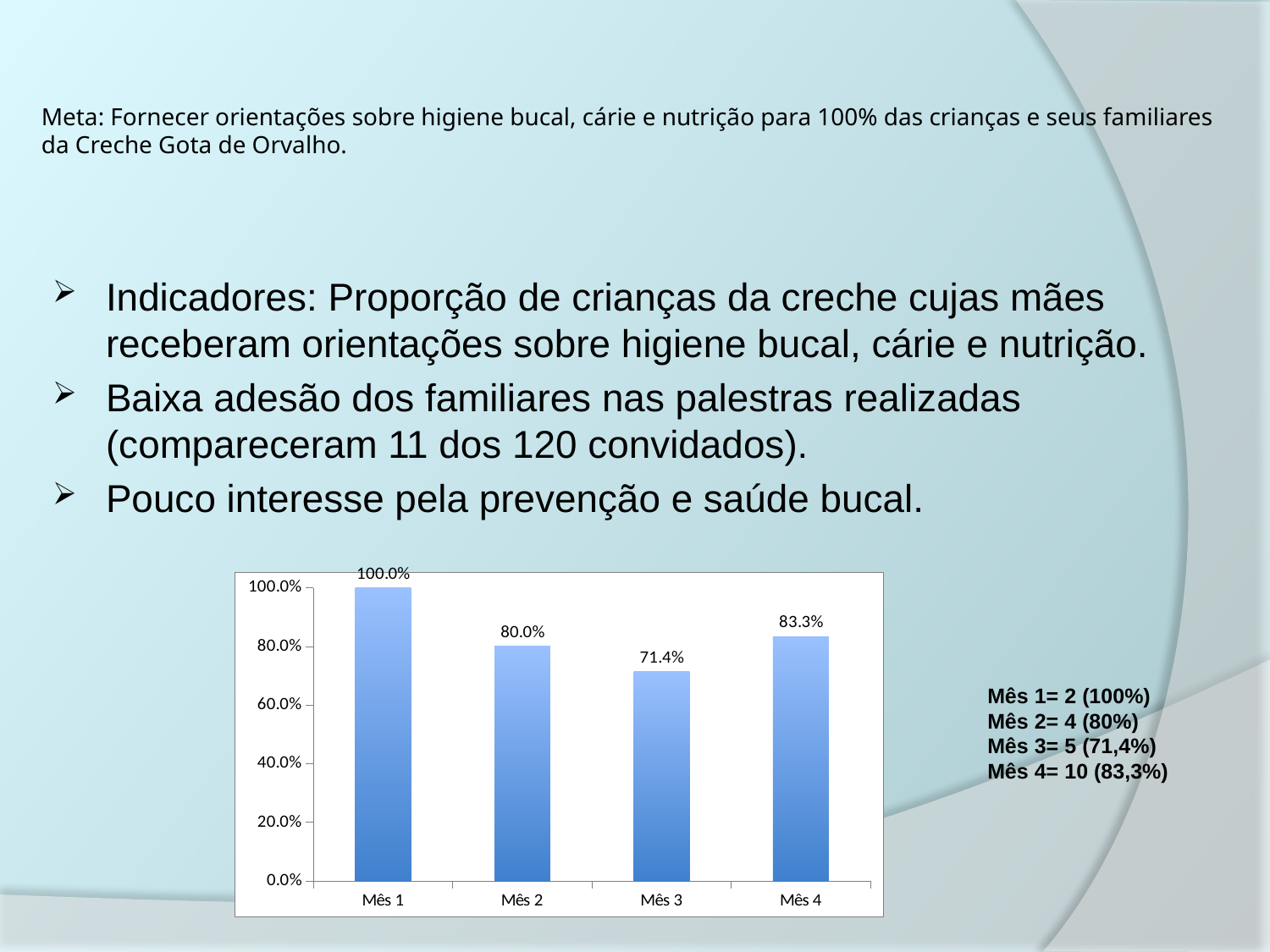
What is the value for Mês 4? 83.3% What is the value for Mês 3? 71.4% What is the difference between the values for Mês 1 and Mês 2? 20.0% What kind of chart is shown on the slide? Bar chart What is the difference between the values for Mês 4 and Mês 3? 11.9% What is the value for Mês 2? 80.0% Which month has the lowest value? Mês 3 Which is larger, the value for Mês 2 or the value for Mês 4? Mês 4 Is the value for Mês 3 greater or less than 80.0%? less Which month has the highest value? Mês 1 What is the value for Mês 1? 100.0% How many months are shown on the x axis of the chart? 4